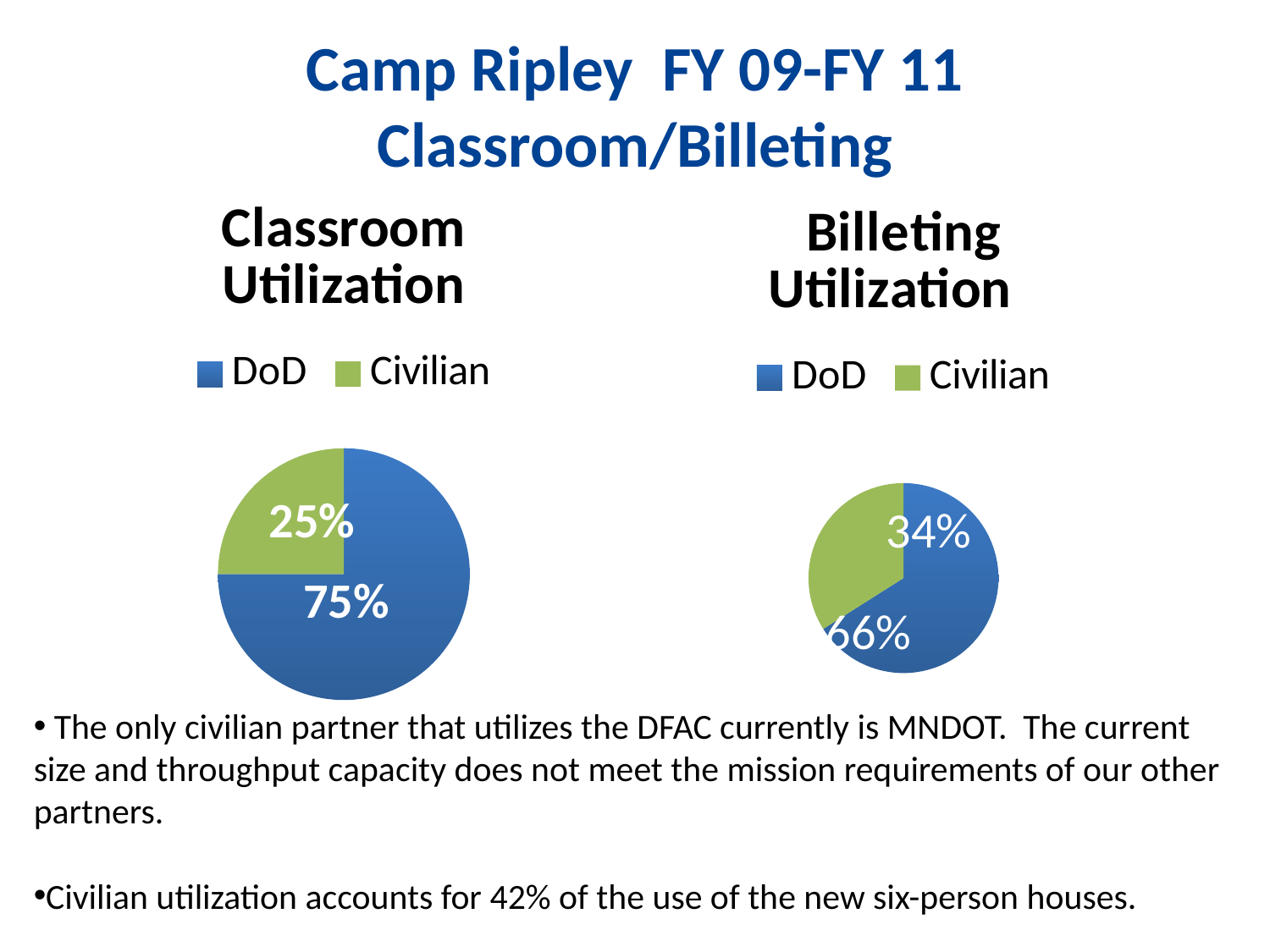
What kind of chart is the Classroom Utilization chart? Pie chart In the Billeting Utilization chart, what is the difference between the DoD and Civilian shares? 32% In the Billeting Utilization chart, which category has the smallest slice? Civilian In the Classroom Utilization chart, what share of the pie is DoD? 75% In the Classroom Utilization chart, what colour is the Civilian slice? Green In the Billeting Utilization chart, what share of the pie is DoD? 66% In the Billeting Utilization chart, what share of the pie is Civilian? 34% In the Classroom Utilization chart, what is the difference between the DoD and Civilian shares? 50% In the Classroom Utilization chart, what share of the pie is Civilian? 25% In the Classroom Utilization chart, which category has the largest slice? DoD How many categories does the legend of the Billeting Utilization chart list? 2 Is the Civilian share larger in the Classroom Utilization chart or the Billeting Utilization chart? Billeting Utilization